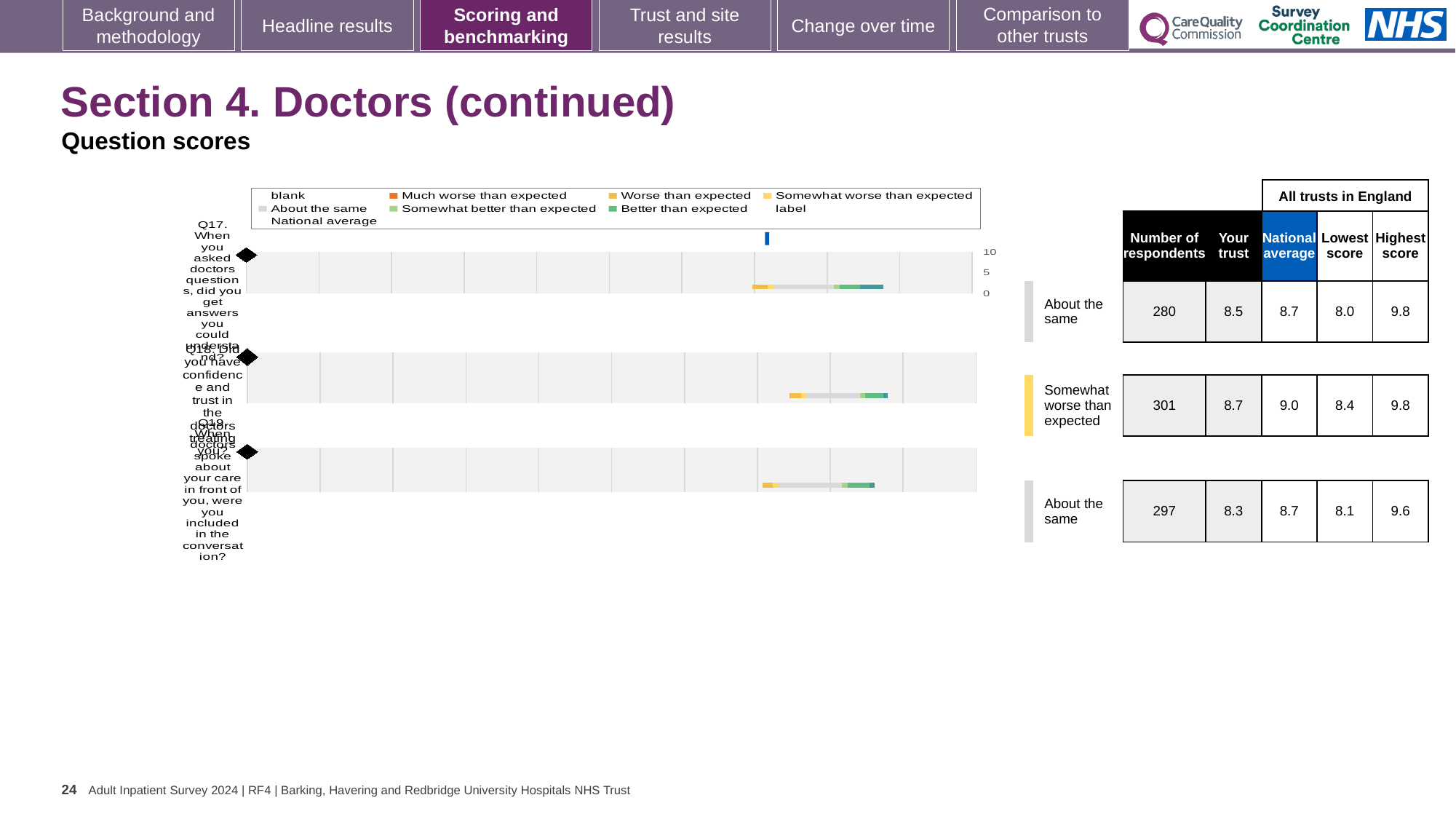
How many entries does the chart's legend list? 9 What kind of chart is shown on the slide? bar chart Which legend entry is shown in orange? Much worse than expected In the table beside the chart, what is the number of respondents for Q17? 280 In the table beside the chart, which question has the most respondents? Q18 In the table beside the chart, what is the 'Your trust' score for Q18? 8.7 In the table beside the chart, is the 'Your trust' score for Q17 larger or smaller than the national average for Q17? smaller In the table beside the chart, what is the national average for Q19? 8.7 What is the highest tick value shown on the chart's axis? 10 How many question categories (bars) does the chart show? 3 In the table beside the chart, what is the highest score for Q18? 9.8 In the table beside the chart, what is the difference between the national average and 'Your trust' score for Q18? 0.3